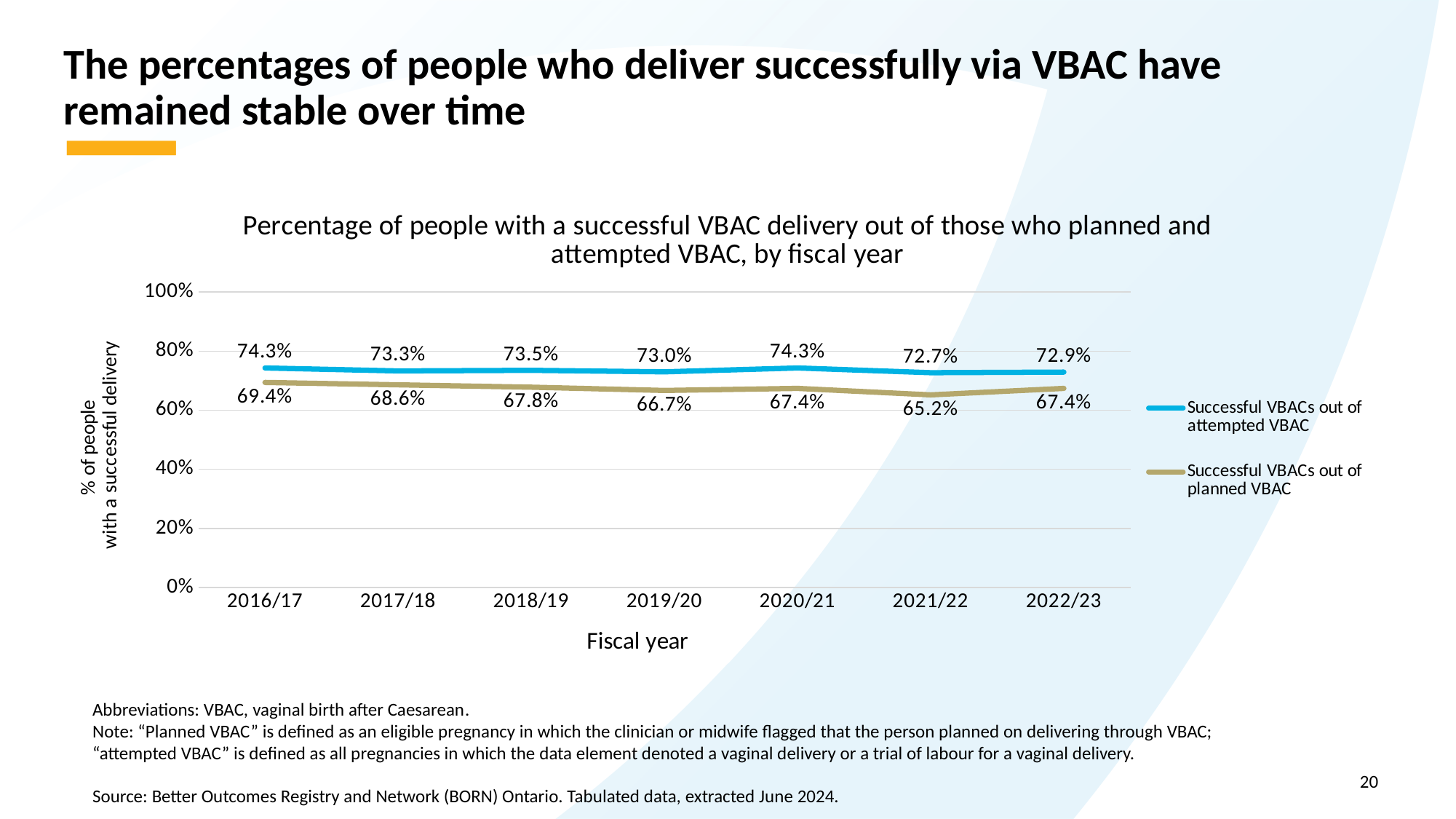
What is the label of the x axis? Fiscal year In which fiscal year is the value for Successful VBACs out of attempted VBAC lowest? 2021/22 Which is larger in 2018/19: Successful VBACs out of attempted VBAC or Successful VBACs out of planned VBAC? Successful VBACs out of attempted VBAC How many series does the legend list? 2 How many fiscal years are plotted on the x axis? 7 What is the value for Successful VBACs out of attempted VBAC in 2022/23? 72.9% In which fiscal year is the value for Successful VBACs out of planned VBAC highest? 2016/17 What is the value for Successful VBACs out of planned VBAC in 2019/20? 66.7% In which fiscal year is the value for Successful VBACs out of planned VBAC lowest? 2021/22 What kind of chart is shown on the slide? Line chart What is the value for Successful VBACs out of attempted VBAC in 2016/17? 74.3% What is the difference between Successful VBACs out of attempted VBAC and Successful VBACs out of planned VBAC in 2021/22? 7.5 percentage points